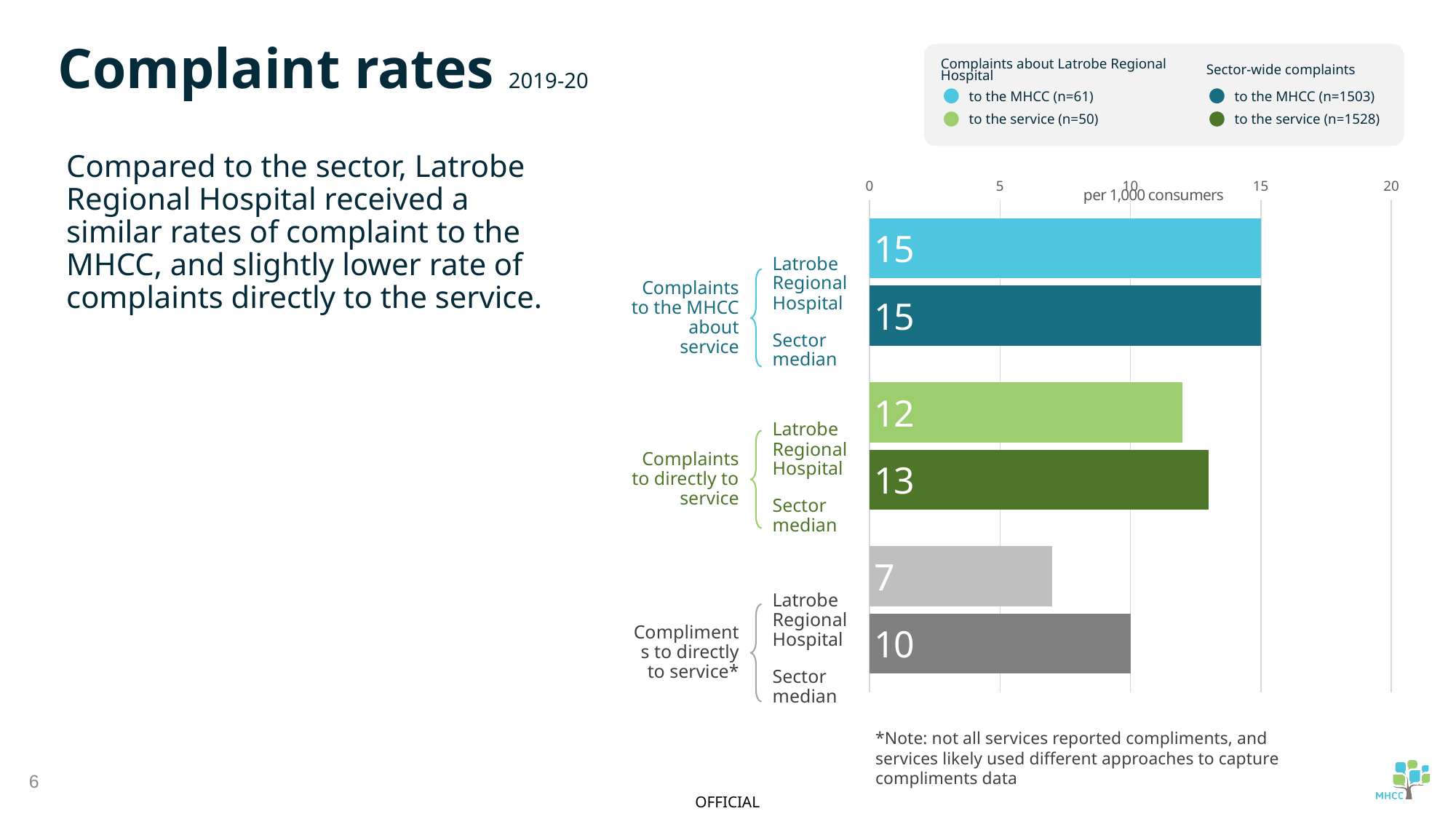
What type of chart is shown on the slide? Bar chart What is the sector median rate of compliments directly to service? 10 What is the difference between the sector median and Latrobe Regional Hospital for compliments directly to service? 3 What is the sector median rate of complaints directly to service? 13 Which bar has the lowest value on the chart? Latrobe Regional Hospital, compliments directly to service How many bars are plotted on the chart? 6 Which is larger: Latrobe Regional Hospital's rate of complaints directly to service or the sector median? Sector median What is the rate of compliments directly to service for Latrobe Regional Hospital? 7 What unit is shown on the chart's axis? per 1,000 consumers What is the rate of complaints to the MHCC about service for Latrobe Regional Hospital? 15 What is the sector median rate of complaints to the MHCC about service? 15 What is the rate of complaints directly to service for Latrobe Regional Hospital? 12